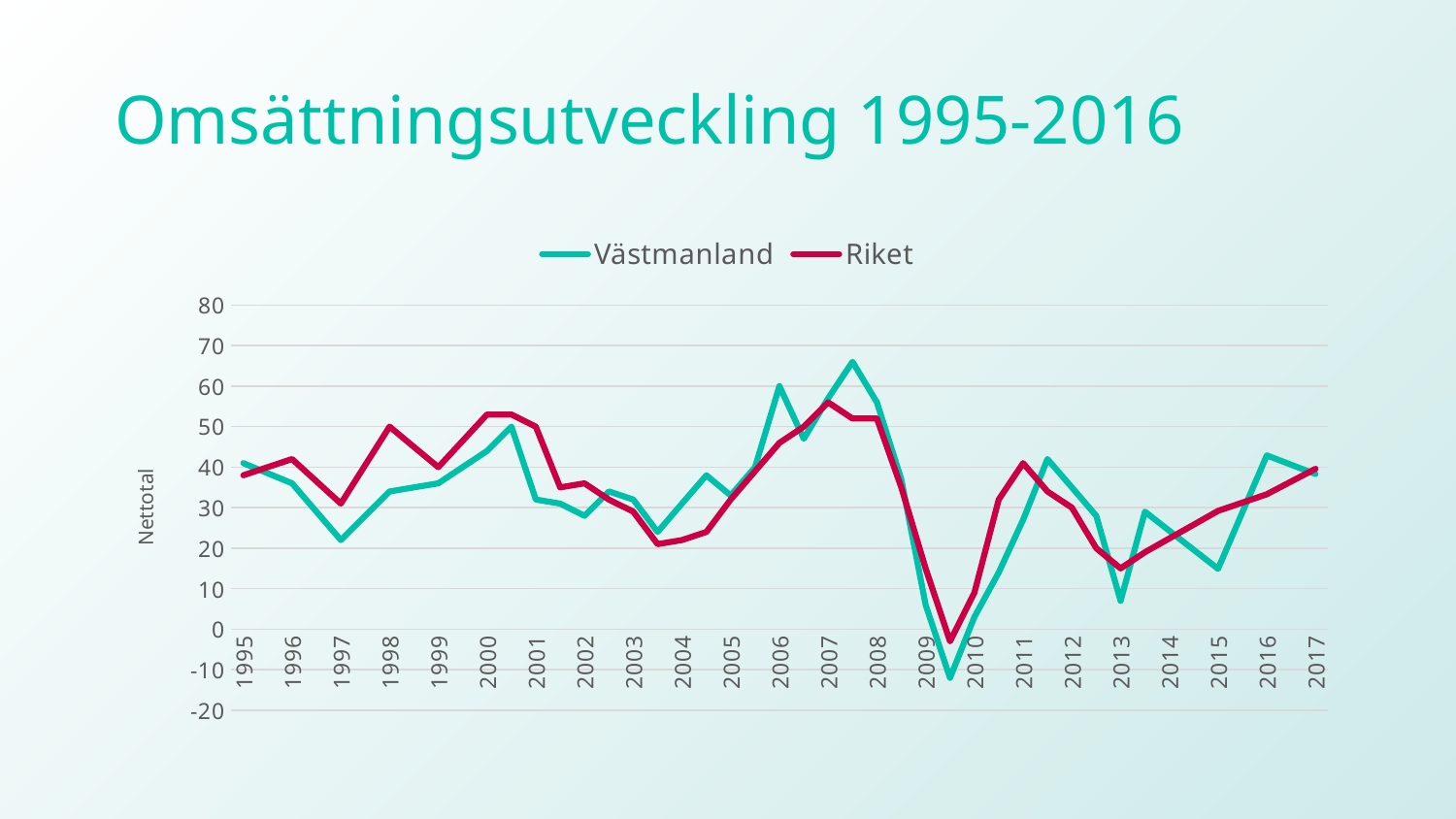
Is the value for Västmanland in 1997 greater or less than 30? less Which series has the higher value in 2006, Västmanland or Riket? Västmanland Is the highest value of the Västmanland line greater or less than 60? greater What kind of chart is shown on the slide? line chart What is the label on the vertical axis? Nettotal How many series does the legend list? 2 Which series reaches the highest peak on the chart? Västmanland How many year labels are shown along the x axis? 23 Which series drops to the lowest value on the chart? Västmanland Does the Riket line rise or fall from 2013 to 2017? rise Is the lowest value of the Västmanland line greater or less than 0? less What are the two series named in the legend? Västmanland and Riket